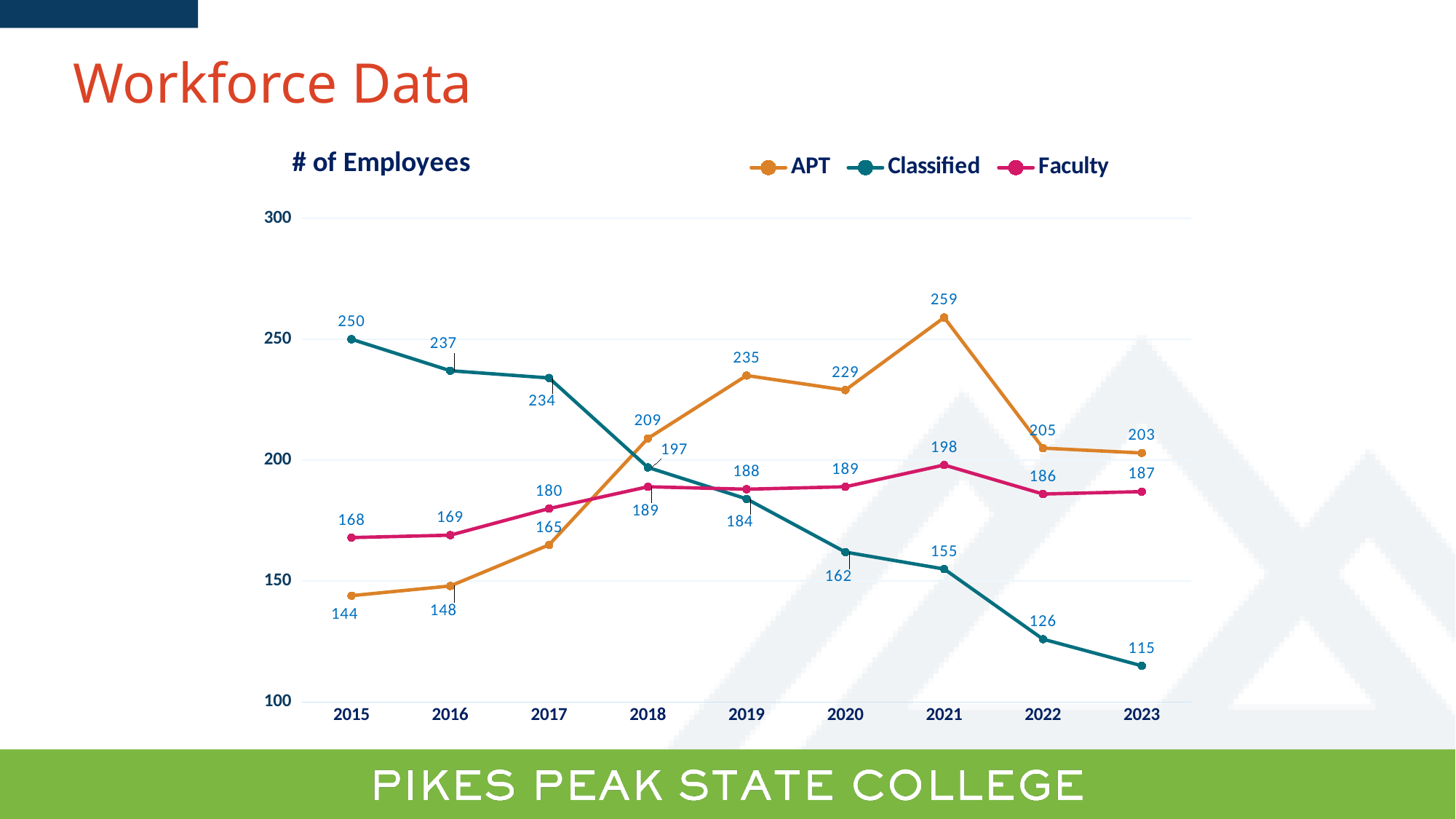
What is the title shown above the chart's y axis? # of Employees In which year is the APT series at its highest? 2021 What is the number of Classified employees in 2023? 115 What is the difference between the Classified value in 2015 and in 2023? 135 What is the number of Faculty employees in 2017? 180 Does the Classified series rise or fall from 2015 to 2023? Fall How many series does the legend list? 3 Which series has the larger value in 2019, APT or Classified? APT What is the number of APT employees in 2021? 259 What type of chart is shown on the slide? Line chart How many years are plotted along the x axis? 9 In which year is the Classified series at its lowest? 2023